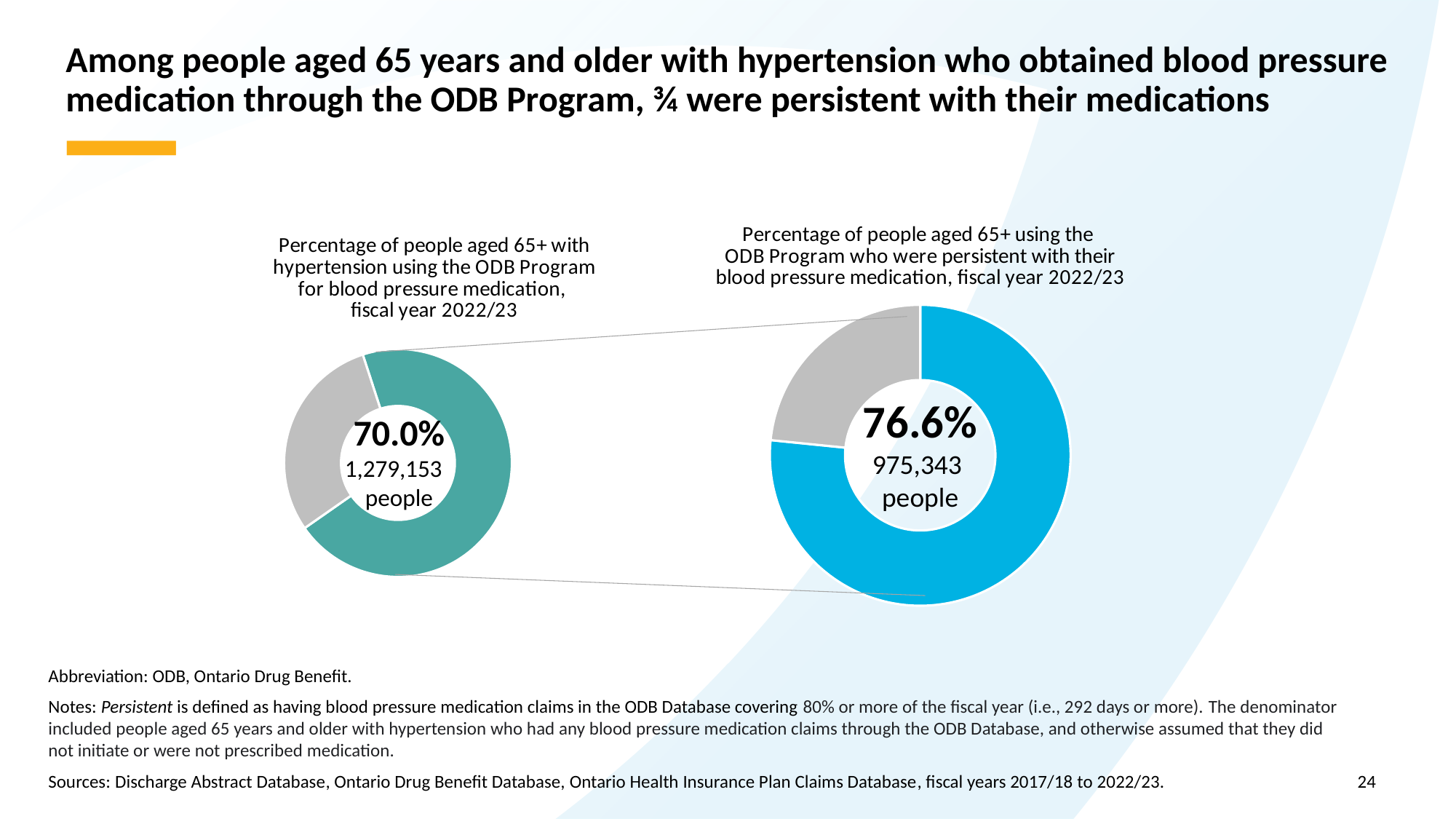
What kind of chart is used on this slide to show the percentages? Donut (pie) chart What is the difference in percentage points between the right chart's value (76.6%) and the left chart's value (70.0%)? 6.6 percentage points In the left chart, what percentage of people aged 65+ with hypertension used the ODB Program for blood pressure medication in fiscal year 2022/23? 70.0% In the right chart, what percentage of people aged 65+ using the ODB Program were persistent with their blood pressure medication? 76.6% How many slices does each donut chart on the slide have? 2 What fiscal year do both charts on the slide refer to? Fiscal year 2022/23 Is the percentage shown in the right chart greater or less than 75%? greater In the right chart, how many people aged 65+ using the ODB Program were persistent with their blood pressure medication? 975,343 people What colour is the highlighted slice in the left chart? Teal (green) In the left chart, how many people aged 65+ with hypertension used the ODB Program for blood pressure medication? 1,279,153 people Which chart shows the larger percentage, the left chart (using the ODB Program) or the right chart (persistent with medication)? The right chart (76.6%) How many more people are shown in the left chart (1,279,153) than in the right chart (975,343)? 303,810 people